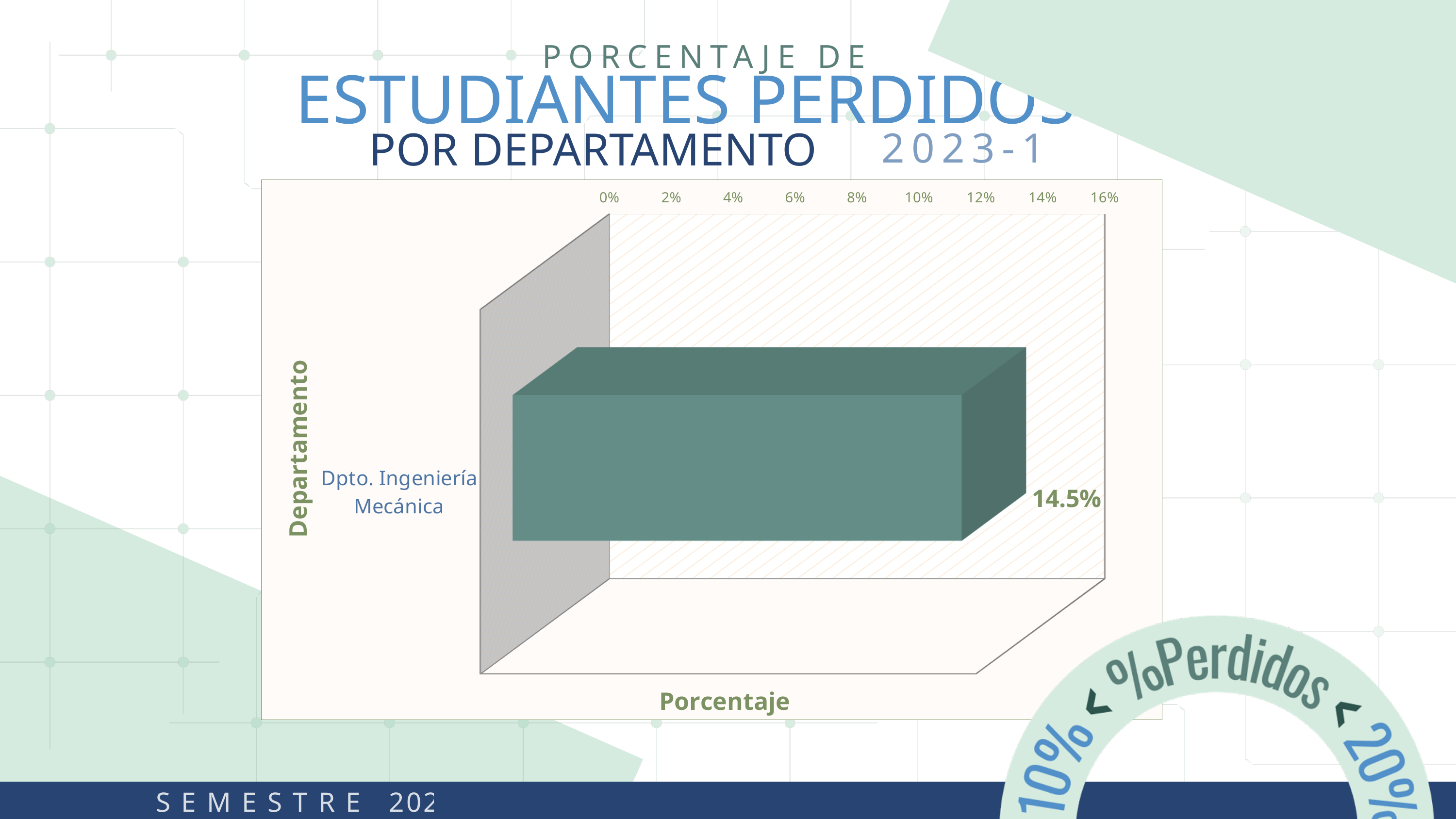
Is the value for Dpto. Ingeniería Mecánica greater or less than 16%? less Is the value for Dpto. Ingeniería Mecánica greater or less than 10%? greater What is the label of the horizontal axis of the chart? Porcentaje Which department is shown in the chart? Dpto. Ingeniería Mecánica What is the label of the vertical axis of the chart? Departamento What is the percentage of lost students for Dpto. Ingeniería Mecánica? 14.5% How many departments are shown in the chart? 1 What is the maximum value shown on the horizontal axis of the chart? 16% What kind of chart is shown on the slide? Bar chart